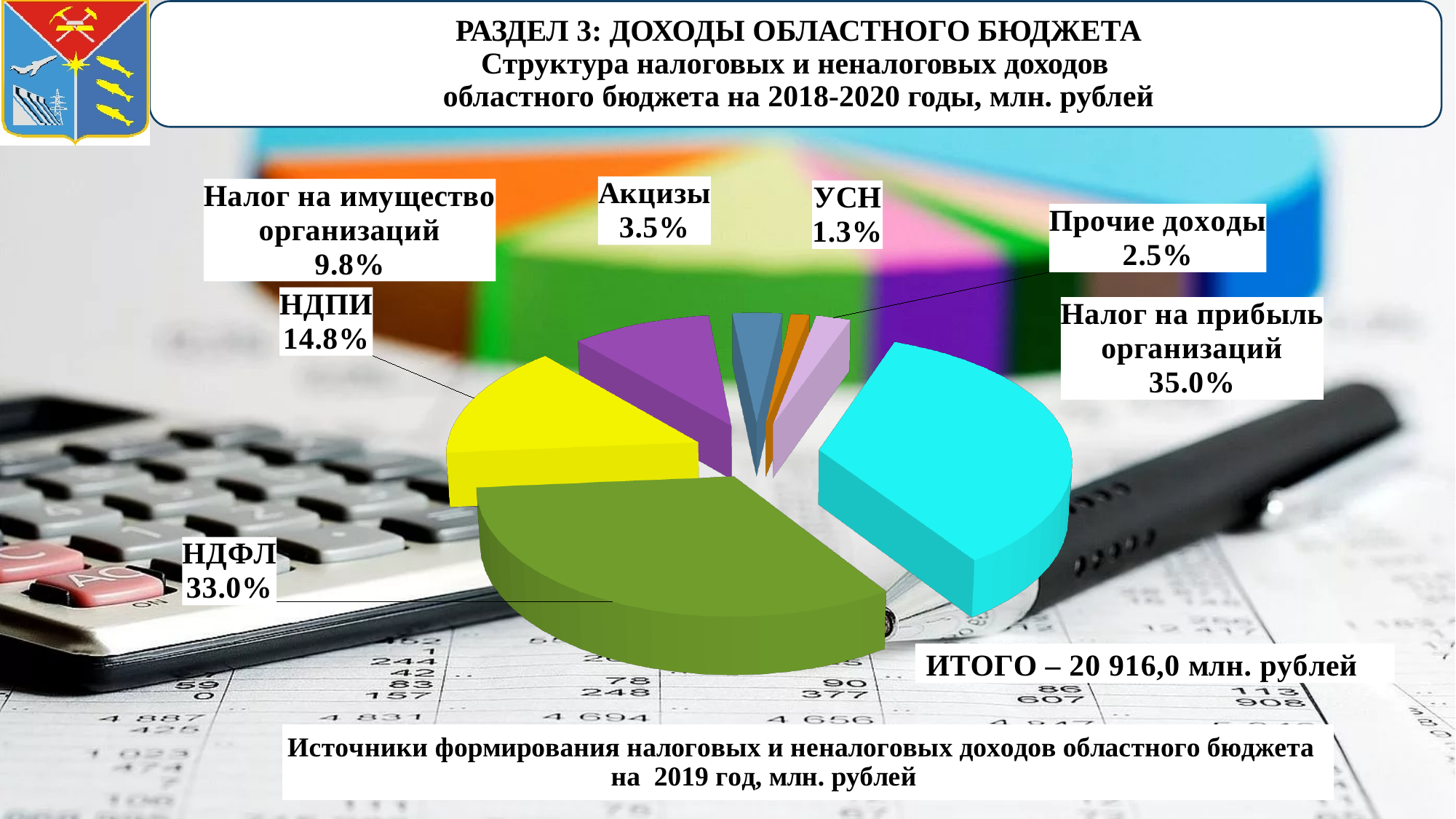
Which category has the largest share of the pie? Налог на прибыль организаций What share of the pie does НДФЛ account for? 33.0% Which category has the smallest share of the pie? УСН What is the value shown for Налог на прибыль организаций? 35.0% Which is larger, the share of НДПИ or the share of Налог на имущество организаций? НДПИ What is the value shown for Прочие доходы? 2.5% What is the value shown for НДПИ? 14.8% What is the value shown for Акцизы? 3.5% What is the difference between the shares of Налог на прибыль организаций and НДФЛ? 2.0% What kind of chart is shown on the slide? pie chart What total amount (ИТОГО) is stated on the slide? 20 916,0 млн. рублей How many slices does the pie chart have? 7